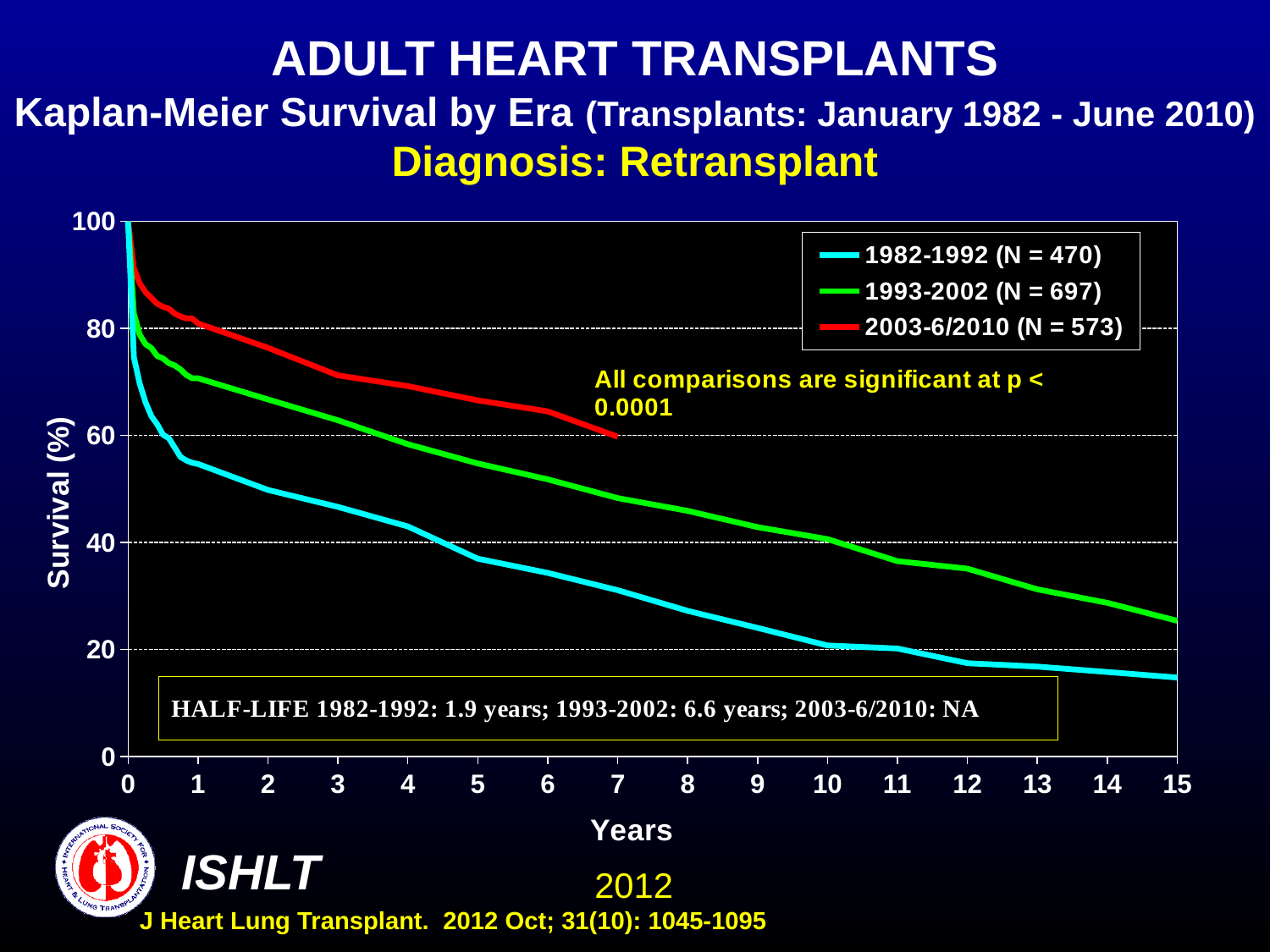
At 5 years, which era has higher survival: 1993-2002 or 1982-1992? 1993-2002 What is the N for the 1993-2002 era shown in the legend? 697 Is the survival for 1993-2002 at 15 years greater or less than 20? greater Is the survival for 1982-1992 at 5 years greater or less than 40? less Is the survival for 1982-1992 at 15 years greater or less than 20? less Which era has the highest survival at 5 years? 2003-6/2010 What colour is the line for the 2003-6/2010 era? red Do the survival curves rise or fall as years increase? fall What kind of chart is shown on the slide? line chart Which era has the lowest survival at 10 years? 1982-1992 How many series does the legend list? 3